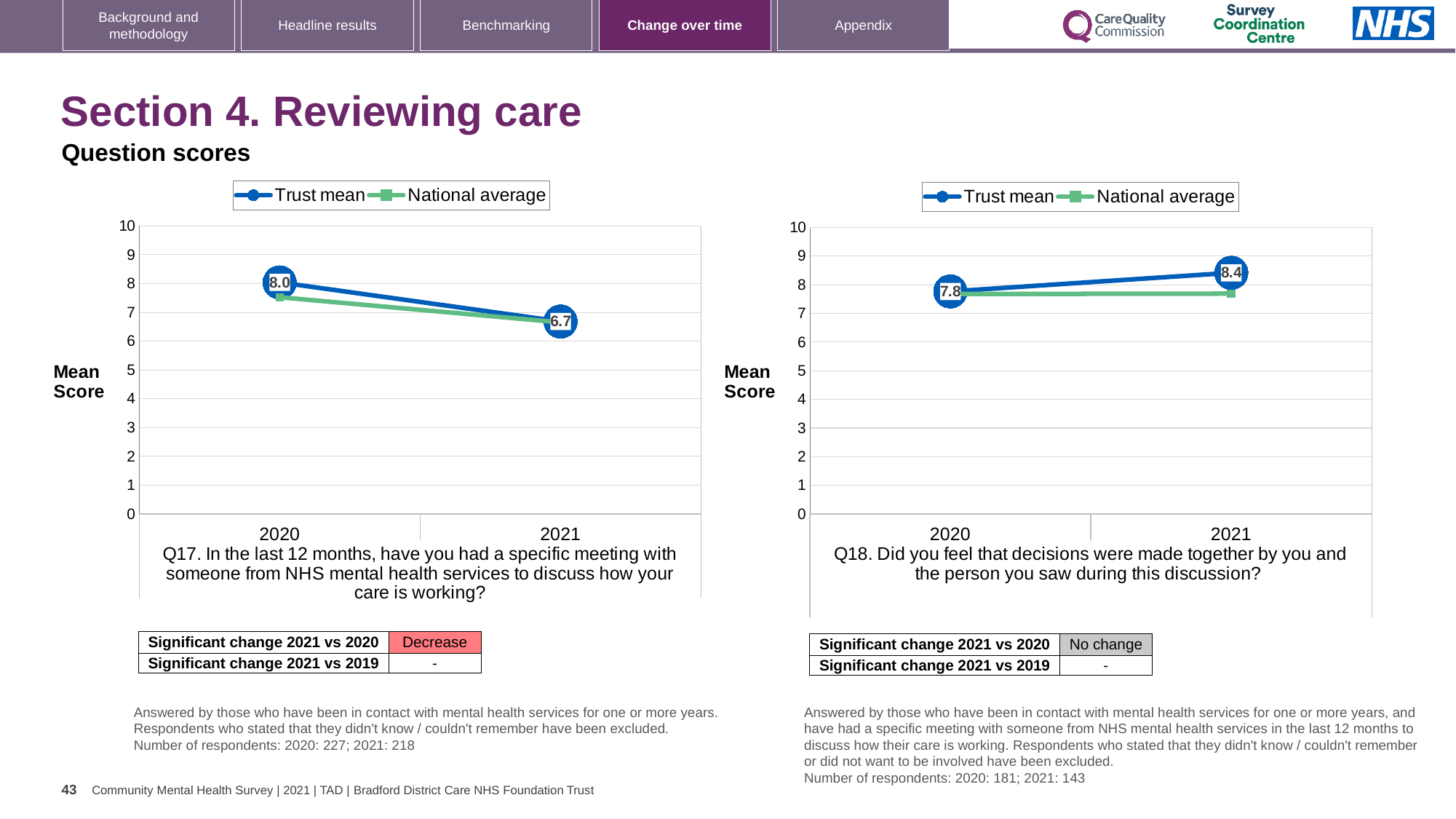
In the left chart (Q17), does the Trust mean rise or fall from 2020 to 2021? fall In the right chart (Q18), which is higher in 2021, the Trust mean or the National average? Trust mean What type of chart is used on the left (Q17)? line chart In the right chart (Q18), what is the difference between the Trust mean in 2021 and in 2020? 0.6 In the left chart (Q17), by how much did the Trust mean fall from 2020 to 2021? 1.3 In the left chart (Q17), what is the Trust mean score for 2020? 8.0 In the left chart (Q17), what is the Trust mean score for 2021? 6.7 In the right chart (Q18), does the Trust mean rise or fall from 2020 to 2021? rise In the right chart (Q18), what is the Trust mean score for 2020? 7.8 In the left chart (Q17), is the National average for 2020 greater or less than 7? greater In the right chart (Q18), what is the Trust mean score for 2021? 8.4 How many series does the legend of the right chart (Q18) list? 2